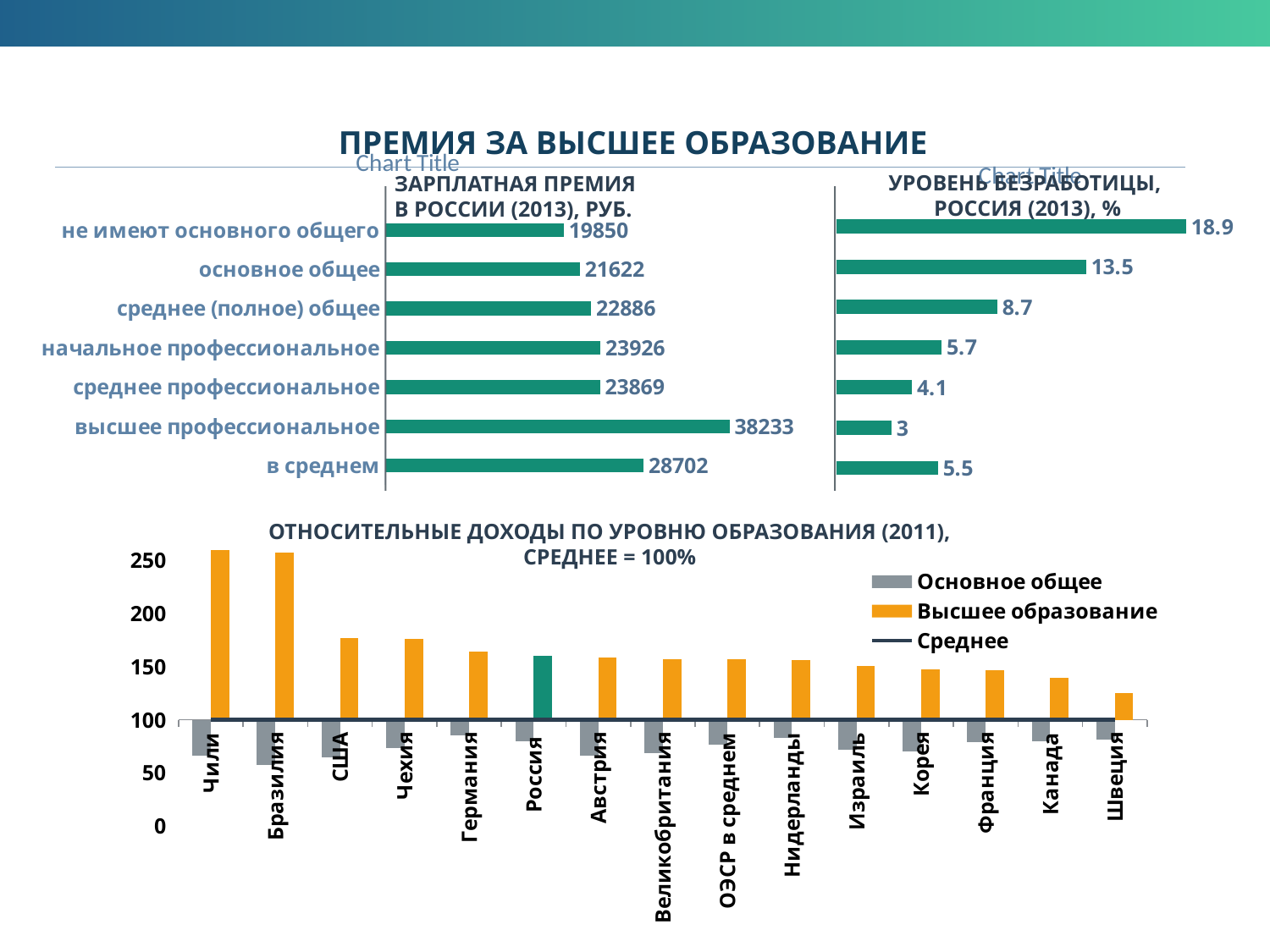
In the chart titled 'УРОВЕНЬ БЕЗРАБОТИЦЫ, РОССИЯ (2013), %', which category has the highest value? не имеют основного общего In the chart titled 'УРОВЕНЬ БЕЗРАБОТИЦЫ, РОССИЯ (2013), %', what is the value for 'основное общее'? 13.5 In the chart titled 'ЗАРПЛАТНАЯ ПРЕМИЯ В РОССИИ (2013), РУБ.', which category has the lowest value? не имеют основного общего In the chart titled 'ЗАРПЛАТНАЯ ПРЕМИЯ В РОССИИ (2013), РУБ.', what is the value for 'высшее профессиональное'? 38233 In the chart titled 'ОТНОСИТЕЛЬНЫЕ ДОХОДЫ ПО УРОВНЮ ОБРАЗОВАНИЯ (2011), СРЕДНЕЕ = 100%', how many countries/categories are shown on the x axis? 15 In the chart titled 'ОТНОСИТЕЛЬНЫЕ ДОХОДЫ ПО УРОВНЮ ОБРАЗОВАНИЯ (2011), СРЕДНЕЕ = 100%', is the 'Высшее образование' value for Швеция greater or less than 150? less What kind of chart is the one titled 'ЗАРПЛАТНАЯ ПРЕМИЯ В РОССИИ (2013), РУБ.'? bar chart In the chart titled 'ОТНОСИТЕЛЬНЫЕ ДОХОДЫ ПО УРОВНЮ ОБРАЗОВАНИЯ (2011), СРЕДНЕЕ = 100%', how many series does the legend list? 3 In the chart titled 'ЗАРПЛАТНАЯ ПРЕМИЯ В РОССИИ (2013), РУБ.', what is the difference between 'высшее профессиональное' and 'в среднем'? 9531 In the chart titled 'ЗАРПЛАТНАЯ ПРЕМИЯ В РОССИИ (2013), РУБ.', what is the value for 'в среднем'? 28702 In the chart titled 'УРОВЕНЬ БЕЗРАБОТИЦЫ, РОССИЯ (2013), %', which category has the lowest value? высшее профессиональное In the chart titled 'УРОВЕНЬ БЕЗРАБОТИЦЫ, РОССИЯ (2013), %', which is larger: 'начальное профессиональное' or 'среднее профессиональное'? начальное профессиональное